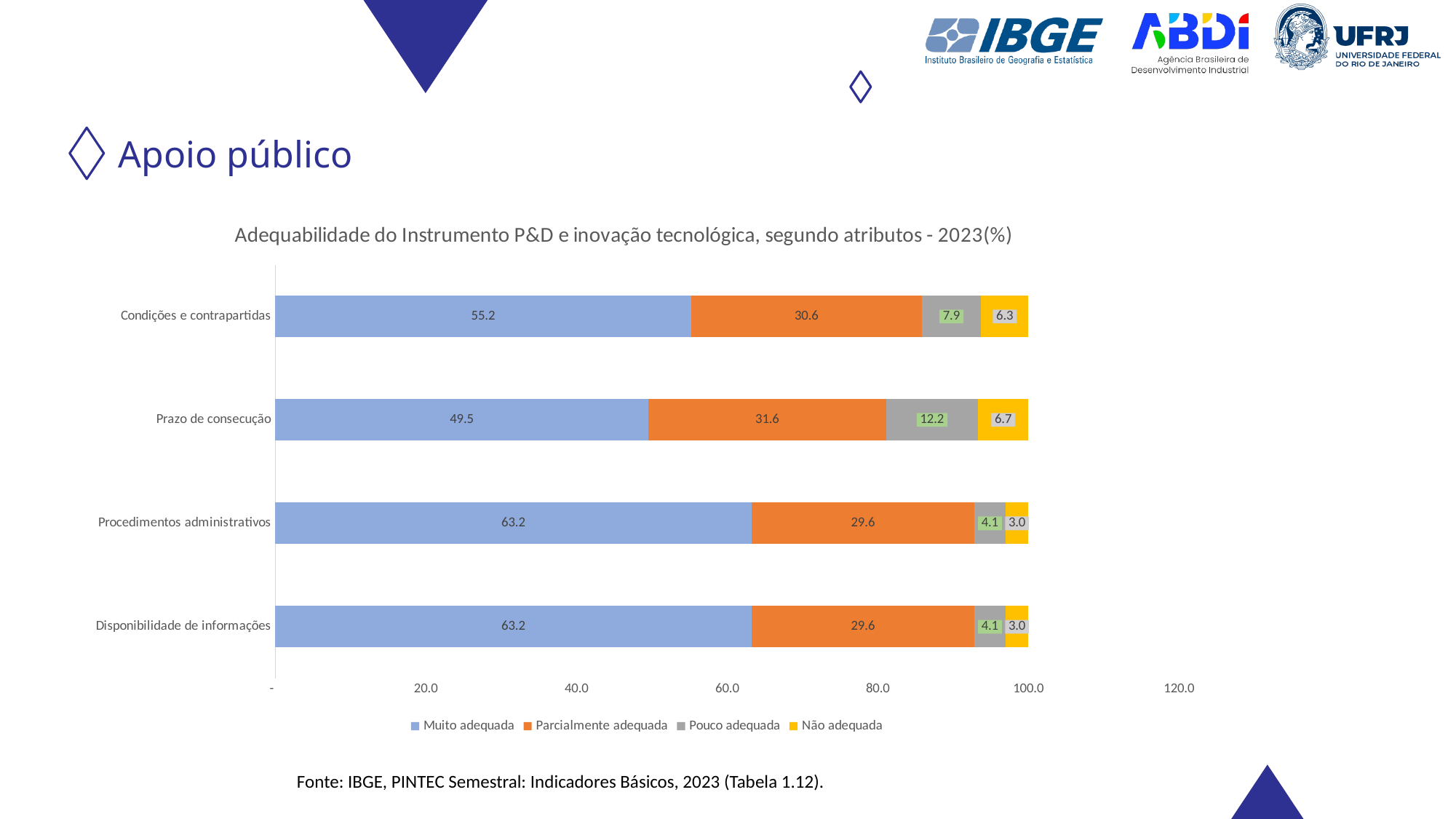
How many series does the legend list? 4 What is the 'Parcialmente adequada' value for 'Condições e contrapartidas'? 30.6 What is the difference between the 'Muito adequada' values for 'Procedimentos administrativos' and 'Prazo de consecução'? 13.7 What is the total of the stacked bar for 'Prazo de consecução'? 100.0 Which category has the highest 'Pouco adequada' value? Prazo de consecução What is the 'Não adequada' value for 'Disponibilidade de informações'? 3.0 What is the 'Muito adequada' value for 'Prazo de consecução'? 49.5 What type of chart is shown on the slide? Stacked bar chart What is the 'Pouco adequada' value for 'Procedimentos administrativos'? 4.1 Which is larger: the 'Parcialmente adequada' value for 'Prazo de consecução' or for 'Condições e contrapartidas'? Prazo de consecução Which category has the lowest 'Muito adequada' value? Prazo de consecução How many categories are shown on the y axis? 4